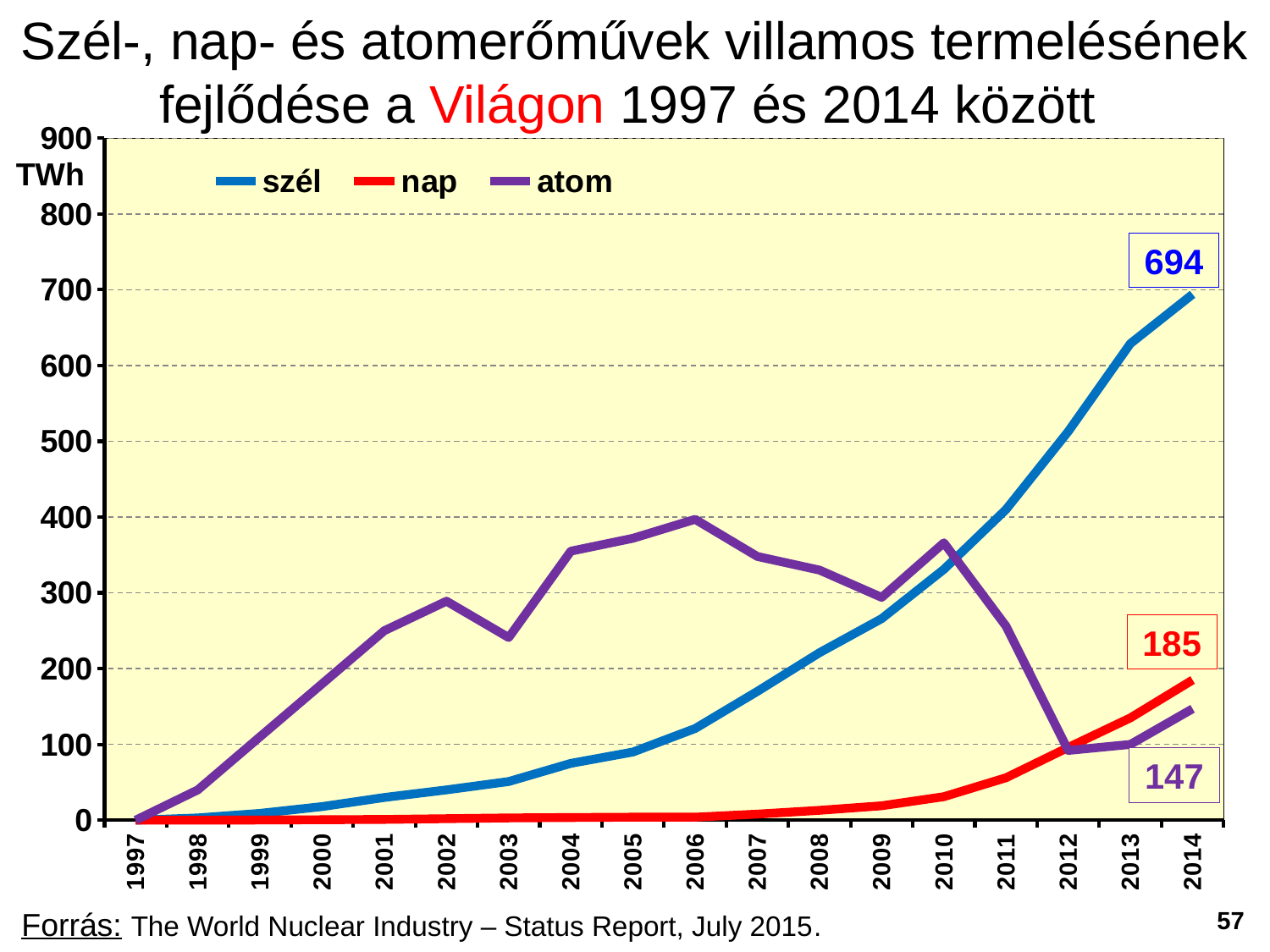
What is the difference between the szél and nap values in 2014? 509 How many years are shown on the x axis? 18 What is the value of the atom series in 2014? 147 What is the value of the szél series in 2014? 694 Is the value of the atom series in 2006 greater or less than 300? greater What type of chart is shown on the slide? line chart Does the szél series rise or fall from 1997 to 2014? rise How many series does the legend list? 3 What is the value of the nap series in 2014? 185 Which series has the highest value in 2014? szél In 2014, which is larger: the nap value or the atom value? nap Which series has the lowest value in 2014? atom